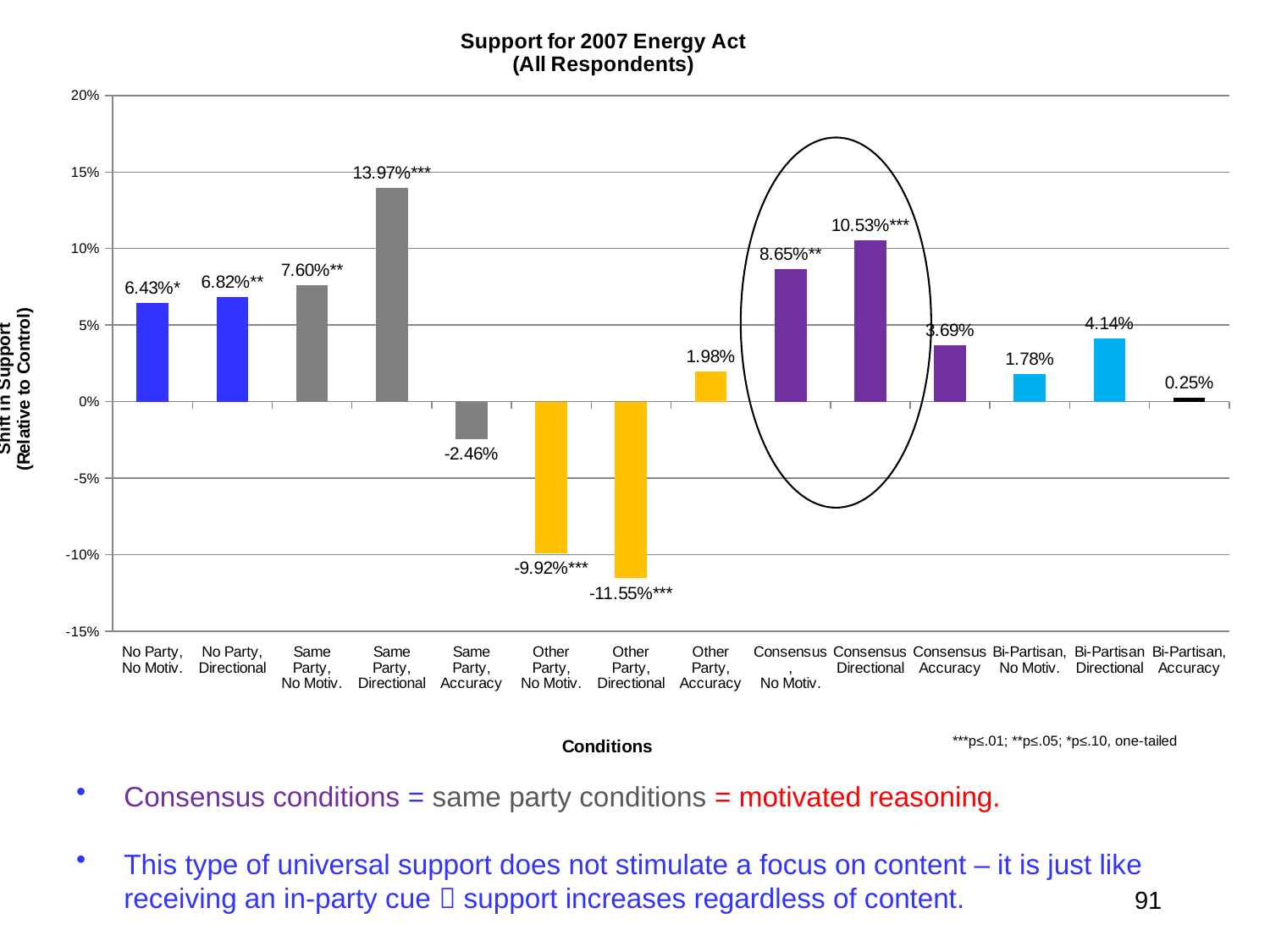
Is the value for Other Party, No Motiv. greater or less than -5%? less What kind of chart is shown on the slide? bar chart What is the value for the Bi-Partisan, Accuracy condition? 0.25% What is the difference between the Same Party, Directional value (13.97%) and the Consensus, Directional value (10.53%)? 3.44% What is the value for the Same Party, Directional condition? 13.97%*** Which condition has the lowest shift in support? Other Party, Directional How many conditions are shown on the x axis? 14 Which condition has the highest shift in support? Same Party, Directional What is the value for the Other Party, Directional condition? -11.55%*** What is the value for the Consensus, Directional condition? 10.53%*** What is the title of the chart? Support for 2007 Energy Act (All Respondents) Which is larger, the value for Consensus, No Motiv. or the value for Consensus, Accuracy? Consensus, No Motiv.